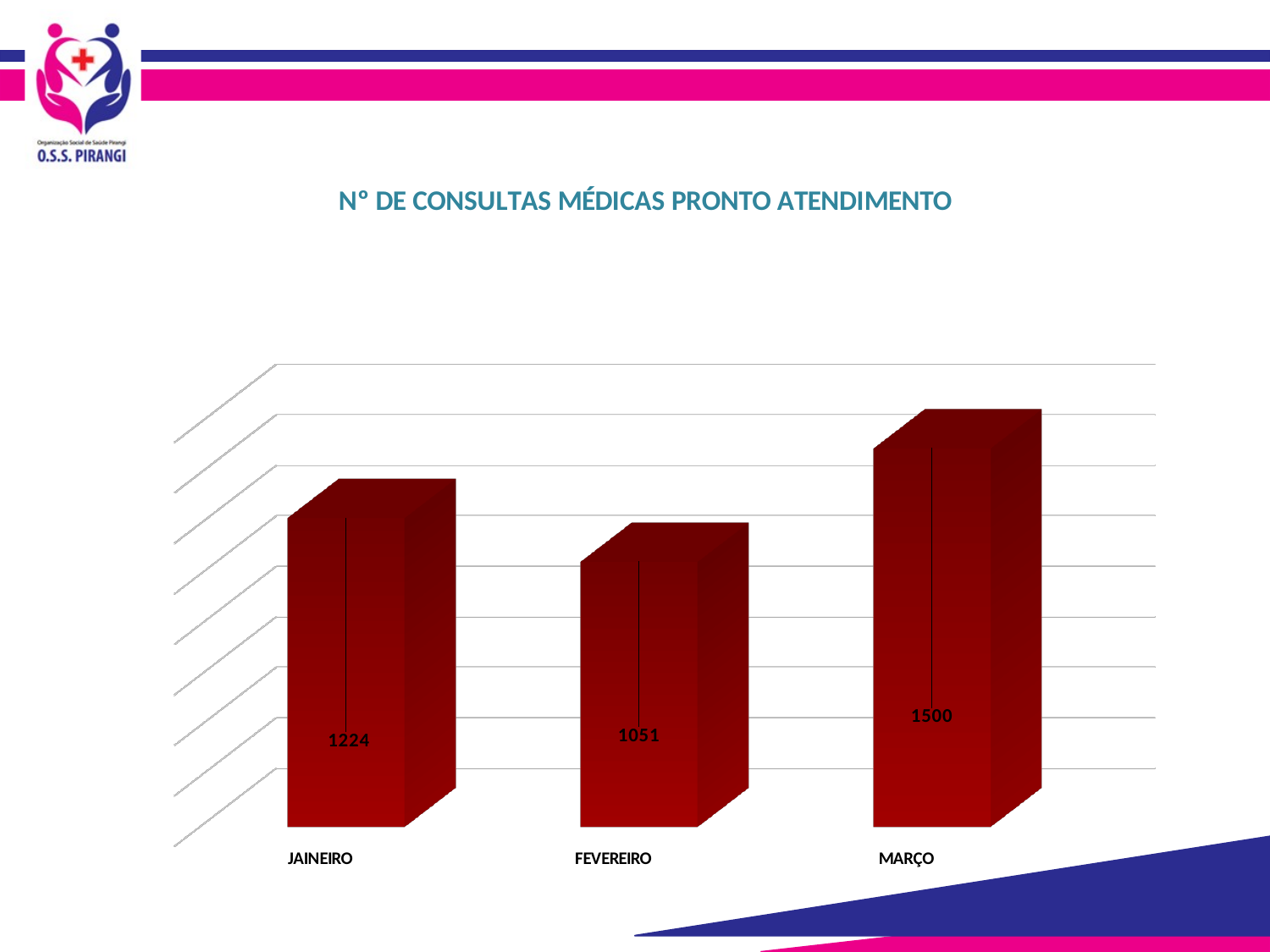
What kind of chart is shown on the slide? bar chart What colour are the bars in the chart? red How many categories are shown on the x axis? 3 What is the value for JAINEIRO? 1224 Which month has the highest number of consultations? MARÇO Which month has the lowest number of consultations? FEVEREIRO Which is larger, the value for JAINEIRO or the value for MARÇO? MARÇO What is the title of the chart? Nº DE CONSULTAS MÉDICAS PRONTO ATENDIMENTO What is the difference between the values for JAINEIRO and FEVEREIRO? 173 What is the value for MARÇO? 1500 What is the value for FEVEREIRO? 1051 What is the difference between the values for MARÇO and FEVEREIRO? 449